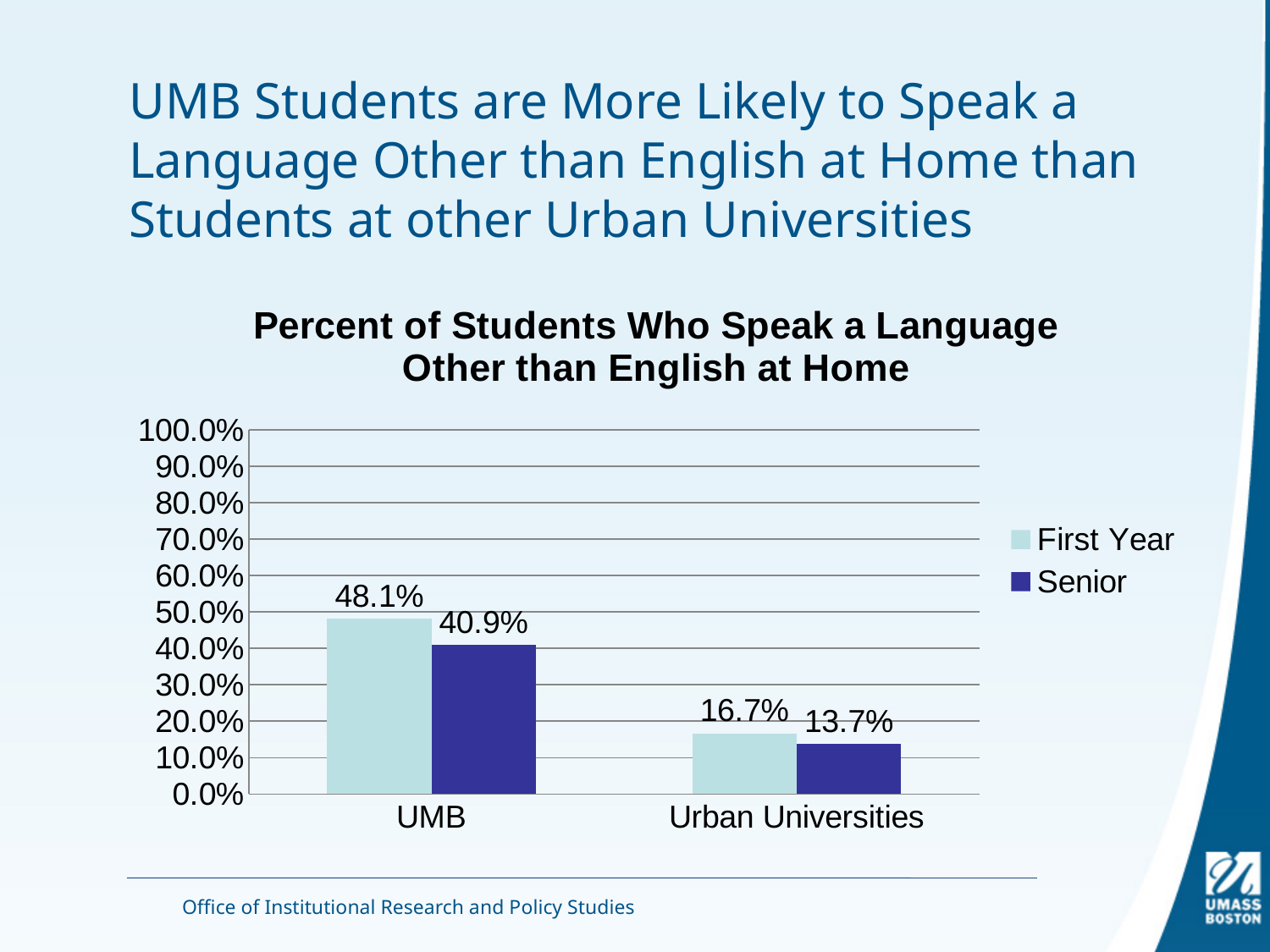
How many series does the legend list? 2 Which is larger: the First Year value for Urban Universities or the Senior value for Urban Universities? First Year Which category has the lowest Senior value? Urban Universities What kind of chart is shown on the slide? bar chart What is the Senior value for Urban Universities? 13.7% What is the Senior value for UMB? 40.9% Which category has the highest First Year value? UMB What is the difference between the First Year and Senior values for UMB? 7.2% How many categories are shown on the x axis? 2 Is the Senior value for UMB greater or less than 50.0%? less What is the First Year value for UMB? 48.1% What is the difference between the First Year values for UMB and Urban Universities? 31.4%